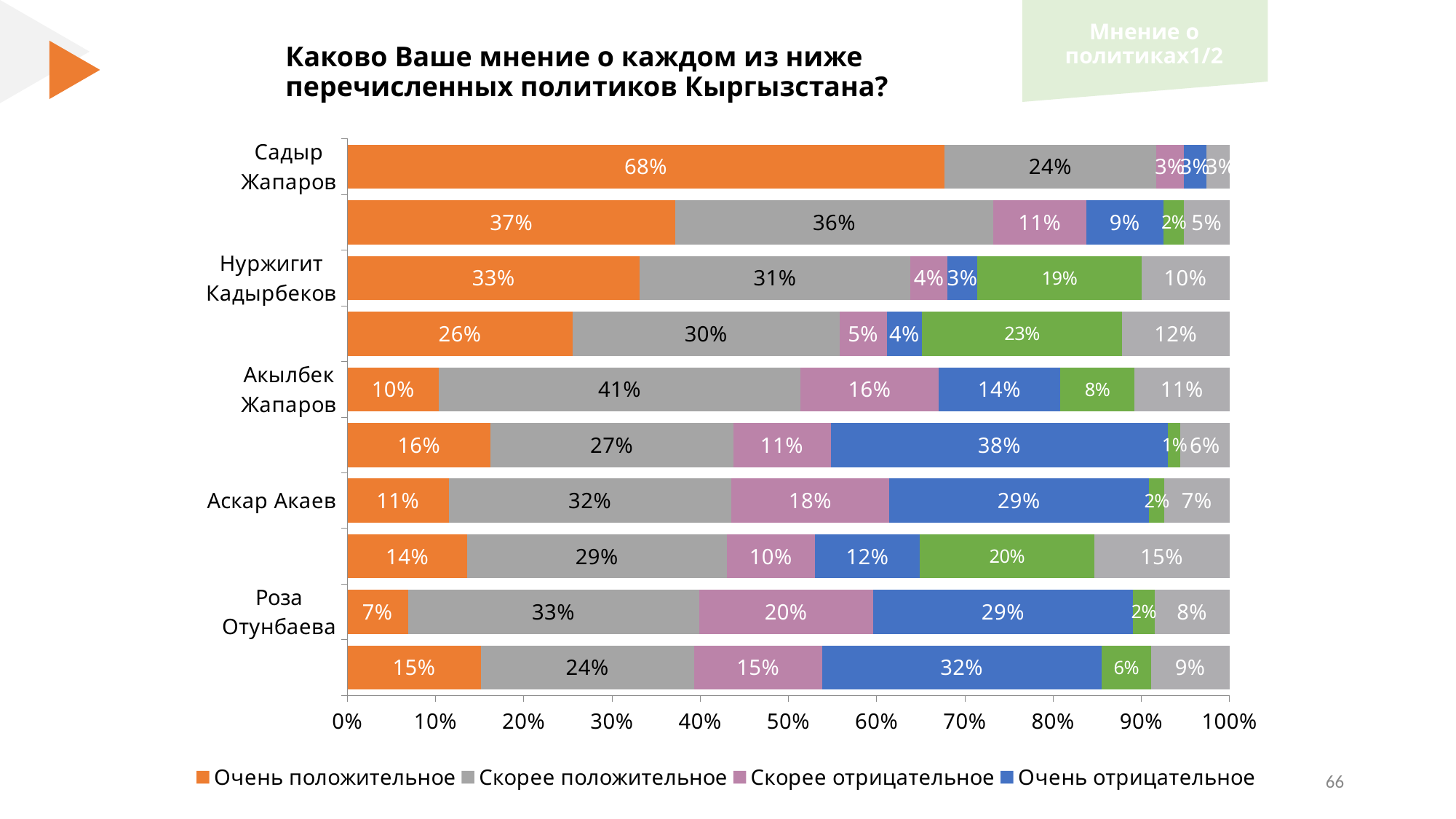
What is the 'Скорее положительное' value for Садыр Жапаров? 24% What is the 'Очень отрицательное' value for Аскар Акаев? 29% What kind of chart is shown on the slide? Stacked bar chart How many series does the legend list? 4 Who has the larger 'Очень отрицательное' value, Акылбек Жапаров or Аскар Акаев? Аскар Акаев What is the 'Скорее положительное' value for Акылбек Жапаров? 41% What is the 'Скорее отрицательное' value for Роза Отунбаева? 20% Which labeled politician has the highest 'Очень положительное' value? Садыр Жапаров What is the difference between the 'Очень положительное' values for Садыр Жапаров and Нуржигит Кадырбеков? 35 percentage points What is the 'Очень положительное' value for Садыр Жапаров? 68% How many bars are plotted in the chart? 10 What is the 'Очень положительное' value for Нуржигит Кадырбеков? 33%